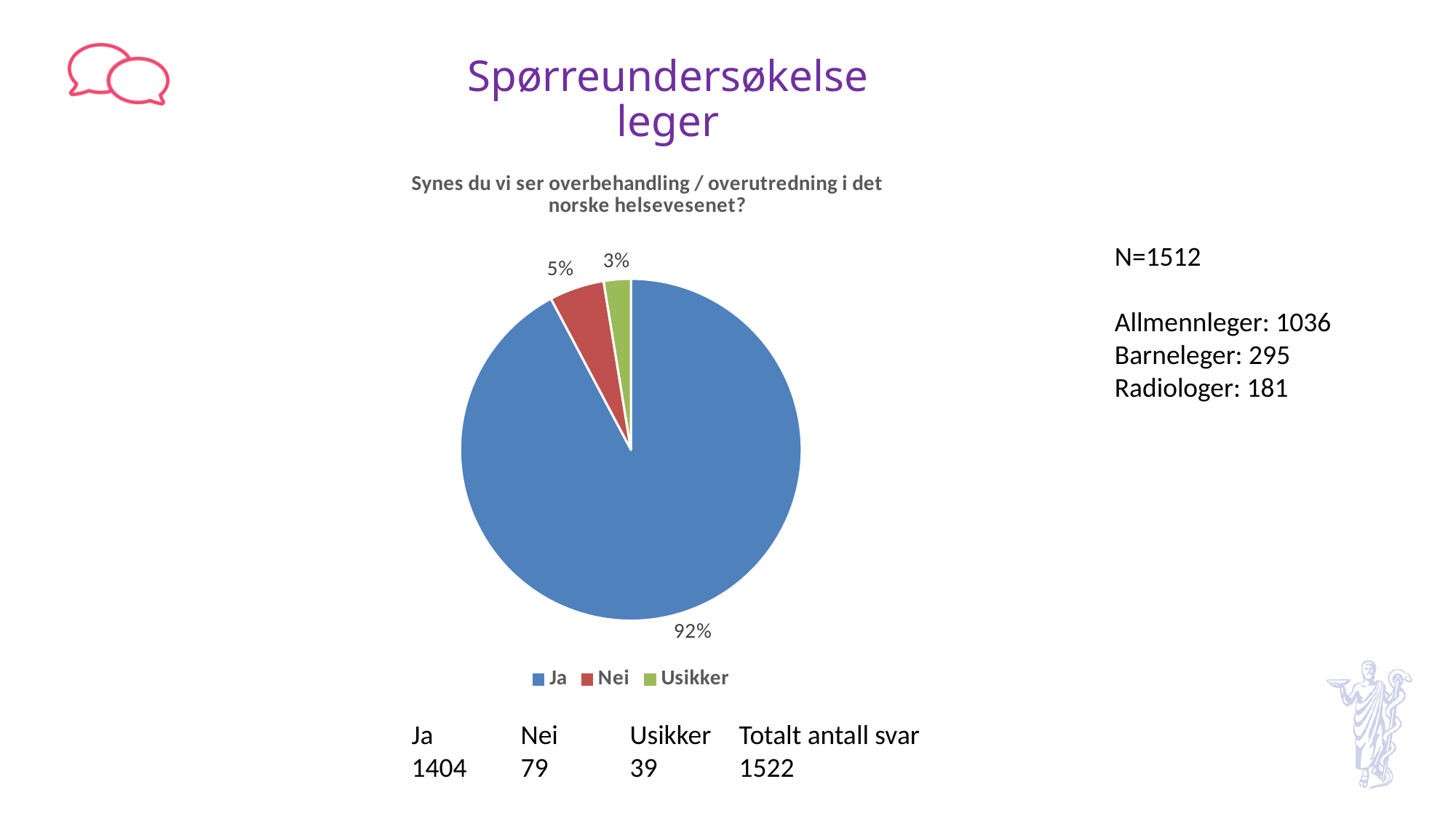
What kind of chart is shown on the slide? pie chart What share of the pie does the "Nei" slice represent? 5% How many entries does the legend list? 3 What share of the pie does the "Usikker" slice represent? 3% Which category has the smallest slice of the pie? Usikker What is the difference in percentage points between the "Ja" slice and the "Nei" slice? 87% Which slice is larger, "Nei" or "Usikker"? Nei What colour is the "Nei" slice in the pie chart? red What is the title of the pie chart? Synes du vi ser overbehandling / overutredning i det norske helsevesenet? What share of the pie does the "Ja" slice represent? 92% Which category has the largest slice of the pie? Ja How many categories does the pie chart show? 3